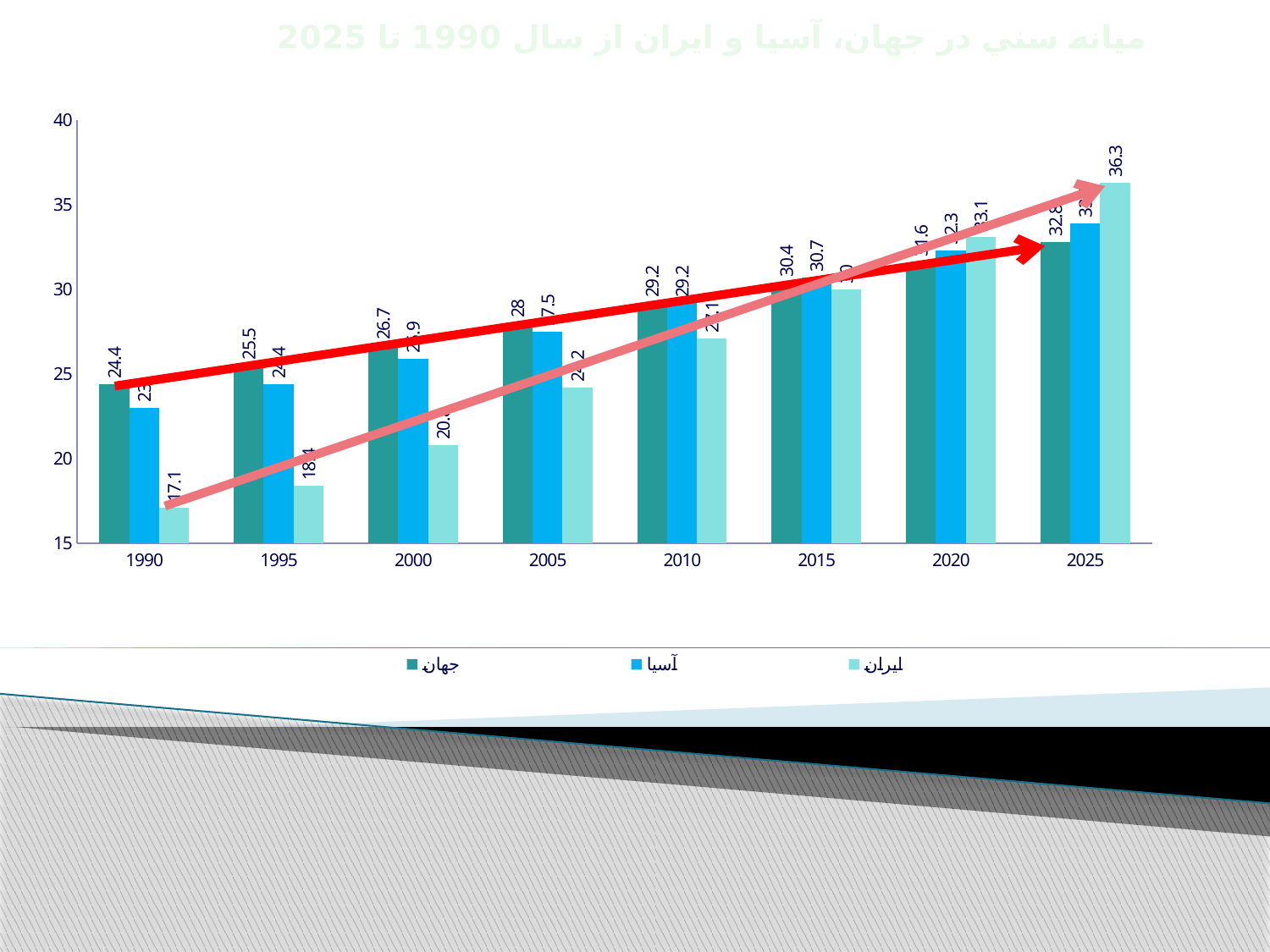
Which is larger in 1990, the value for جهان (World) or for ایران (Iran)? جهان (World) Is the value for ایران (Iran) in 2000 greater or less than 25? less What is the difference between the ایران (Iran) values in 2025 and 1990? 19.2 What is the value for جهان (World) in 2005? 28 What is the value for ایران (Iran) in 1990? 17.1 What is the value for جهان (World) in 1990? 24.4 Which year has the lowest value for جهان (World)? 1990 How many series does the legend list? 3 What is the value for ایران (Iran) in 2025? 36.3 What is the value for آسیا (Asia) in 2015? 30.7 Which year has the highest value for ایران (Iran)? 2025 How many years are shown on the x axis? 8